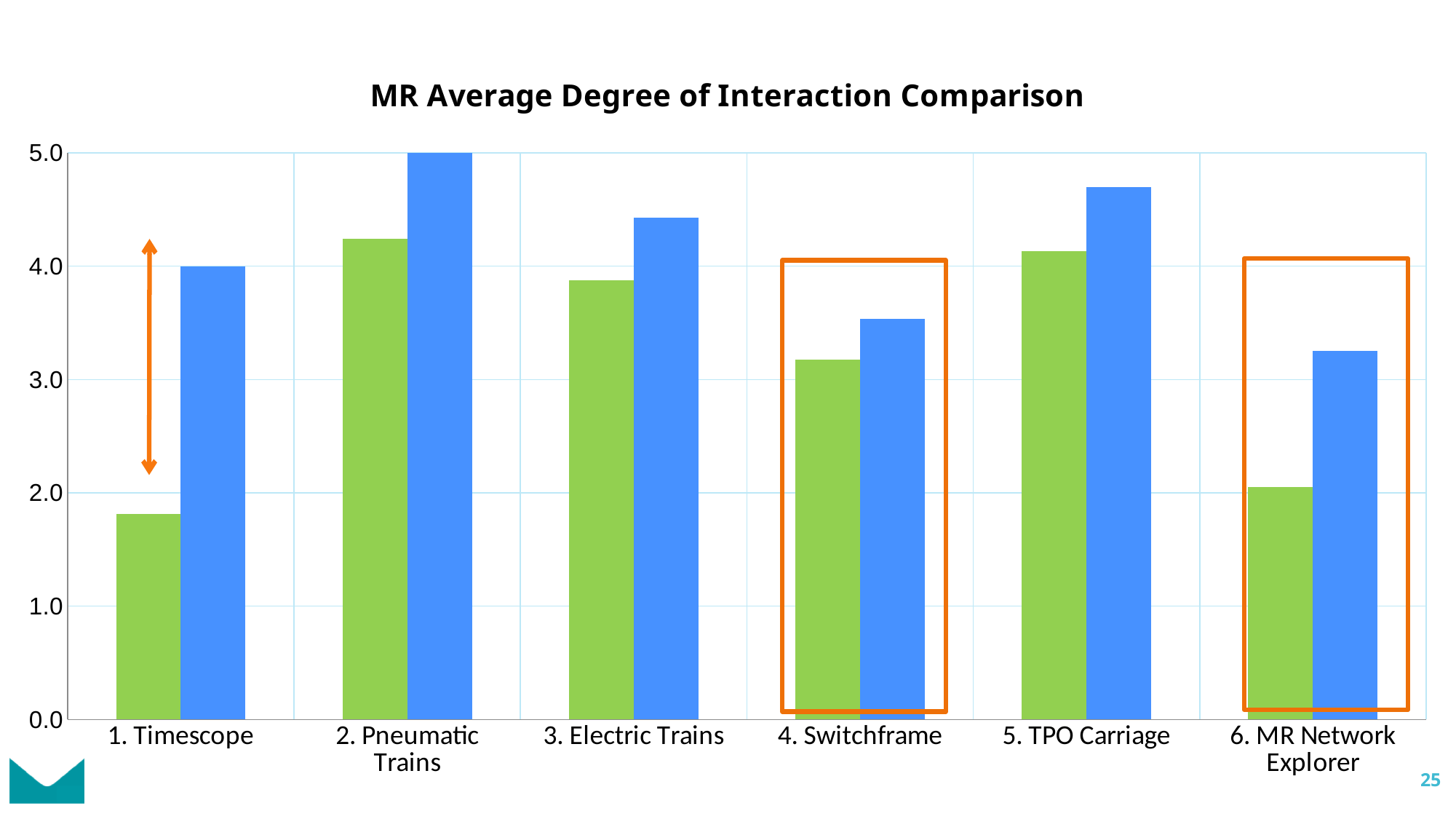
Is the green bar for 1. Timescope greater or less than 2.0? less Is the blue bar for 4. Switchframe greater or less than 3.0? greater What is the title of the chart? MR Average Degree of Interaction Comparison How many categories are shown on the x axis of the chart? 6 Which category has the lowest green bar? 1. Timescope Is the blue bar for 3. Electric Trains greater or less than 4.0? greater What is the value of the blue bar for 2. Pneumatic Trains? 5.0 Which category has the lowest blue bar? 6. MR Network Explorer Which categories are highlighted with orange boxes on the chart? 4. Switchframe and 6. MR Network Explorer What kind of chart is shown on the slide? bar chart Which category has the highest blue bar? 2. Pneumatic Trains For 1. Timescope, which bar is larger, the green bar or the blue bar? the blue bar